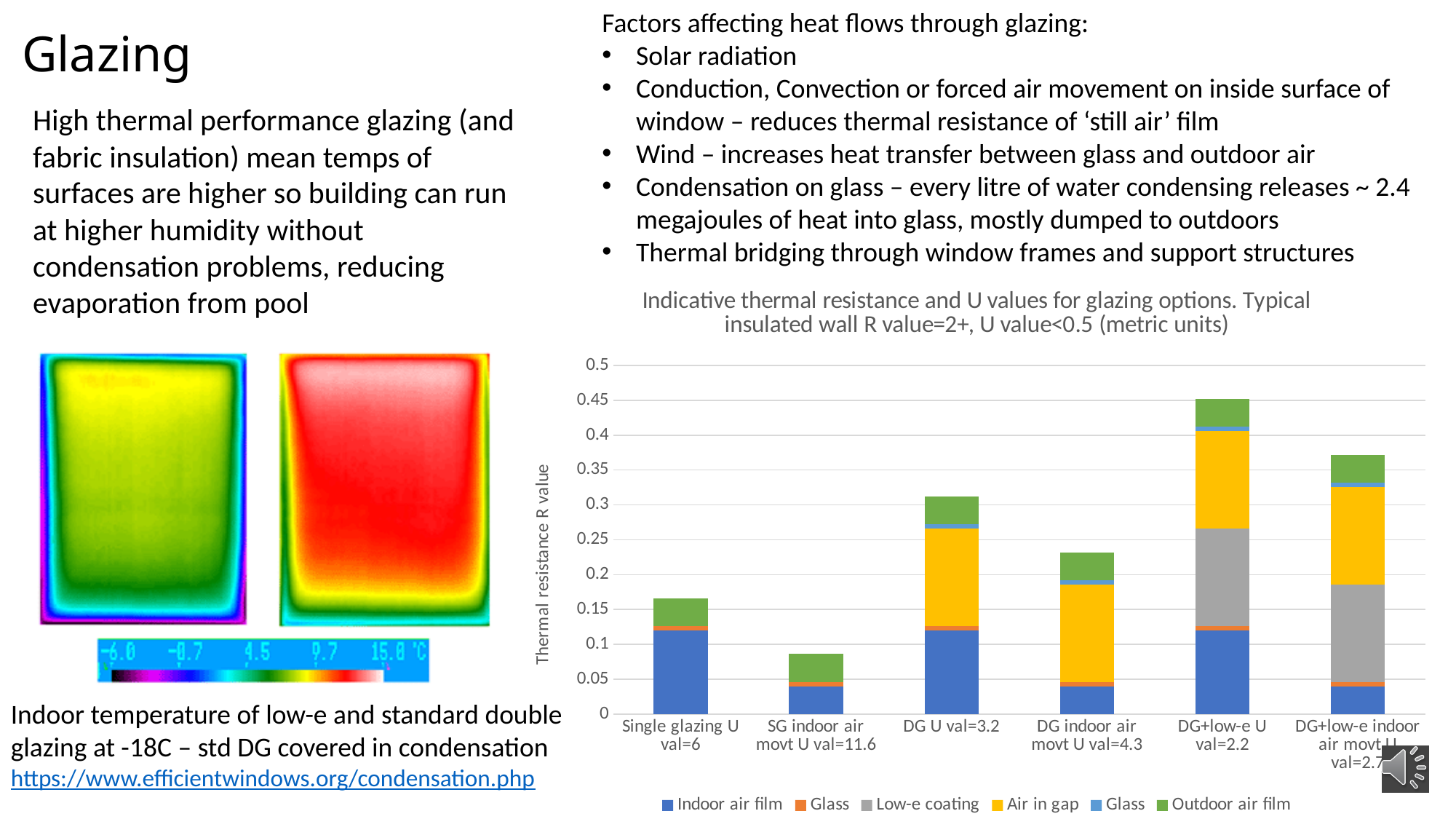
Which glazing option has the lowest total thermal resistance R value? SG indoor air movt U val=11.6 What kind of chart is shown on the slide? Stacked bar chart Which glazing option has the highest total thermal resistance R value? DG+low-e U val=2.2 Is the total R value for Single glazing U val=6 greater or less than 0.15? greater How many series does the chart's legend list? 6 What is the label of the chart's vertical axis? Thermal resistance R value How many glazing options (categories) are plotted on the x axis of the chart? 6 Which legend series is shown in yellow in the chart? Air in gap Is the total R value for SG indoor air movt U val=11.6 greater or less than 0.1? less Is the total R value for DG+low-e U val=2.2 greater or less than 0.4? greater Which has the larger total R value: DG U val=3.2 or DG indoor air movt U val=4.3? DG U val=3.2